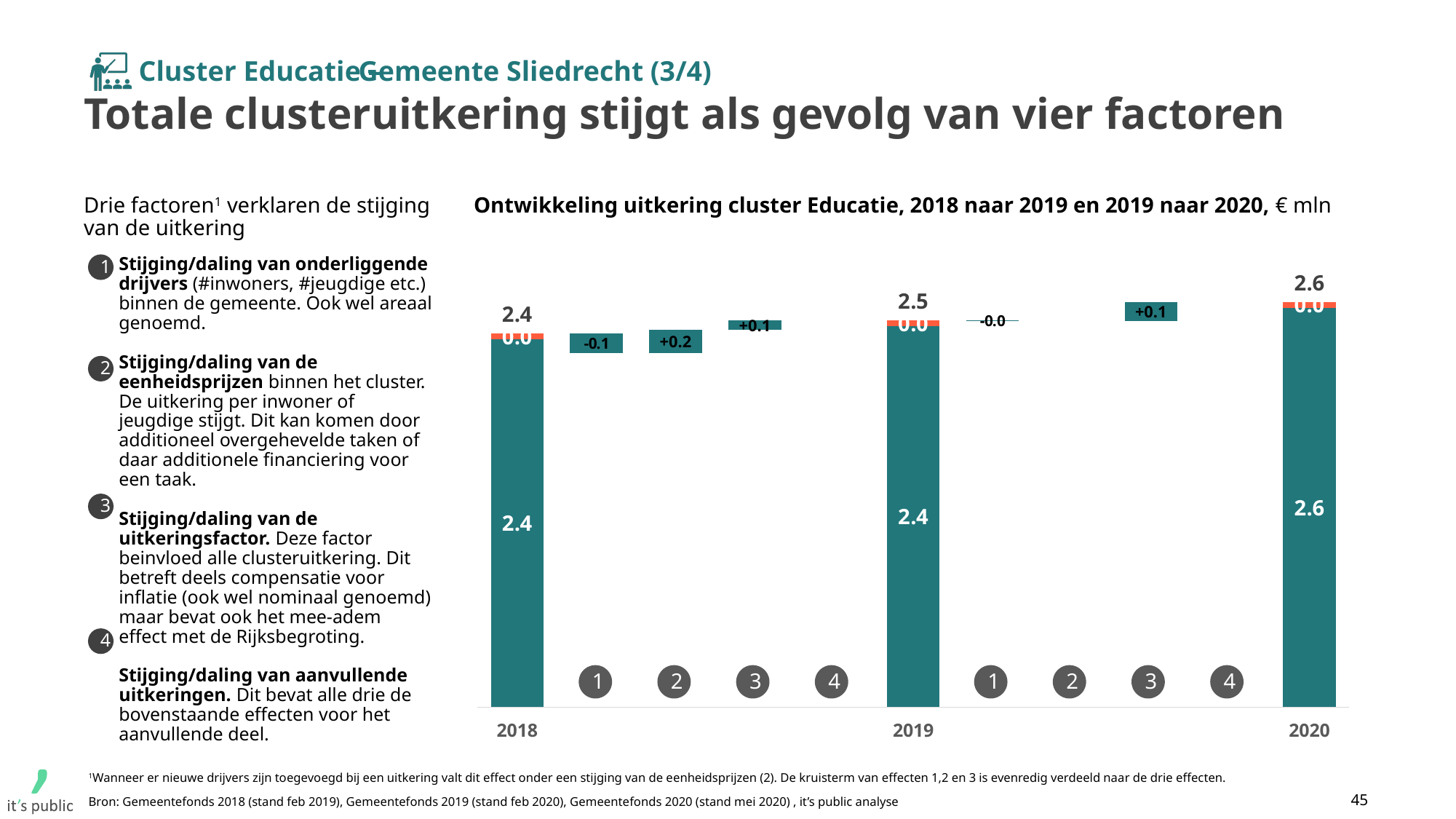
Which year has the highest total uitkering? 2020 What is the total uitkering for cluster Educatie in 2020? 2.6 What is the effect of factor 3 on the uitkering from 2019 to 2020? +0.1 What is the total uitkering for cluster Educatie in 2018? 2.4 Is the total uitkering larger in 2019 or in 2020? 2020 What is the total uitkering for cluster Educatie in 2019? 2.5 Do the total uitkering values rise or fall from 2018 to 2020? rise What is the effect of factor 1 on the uitkering from 2018 to 2019? -0.1 Which year has the lowest total uitkering? 2018 By how much does the total uitkering increase from 2018 to 2020? 0.2 In what unit are the values in the chart expressed? € mln What is the effect of factor 2 on the uitkering from 2018 to 2019? +0.2